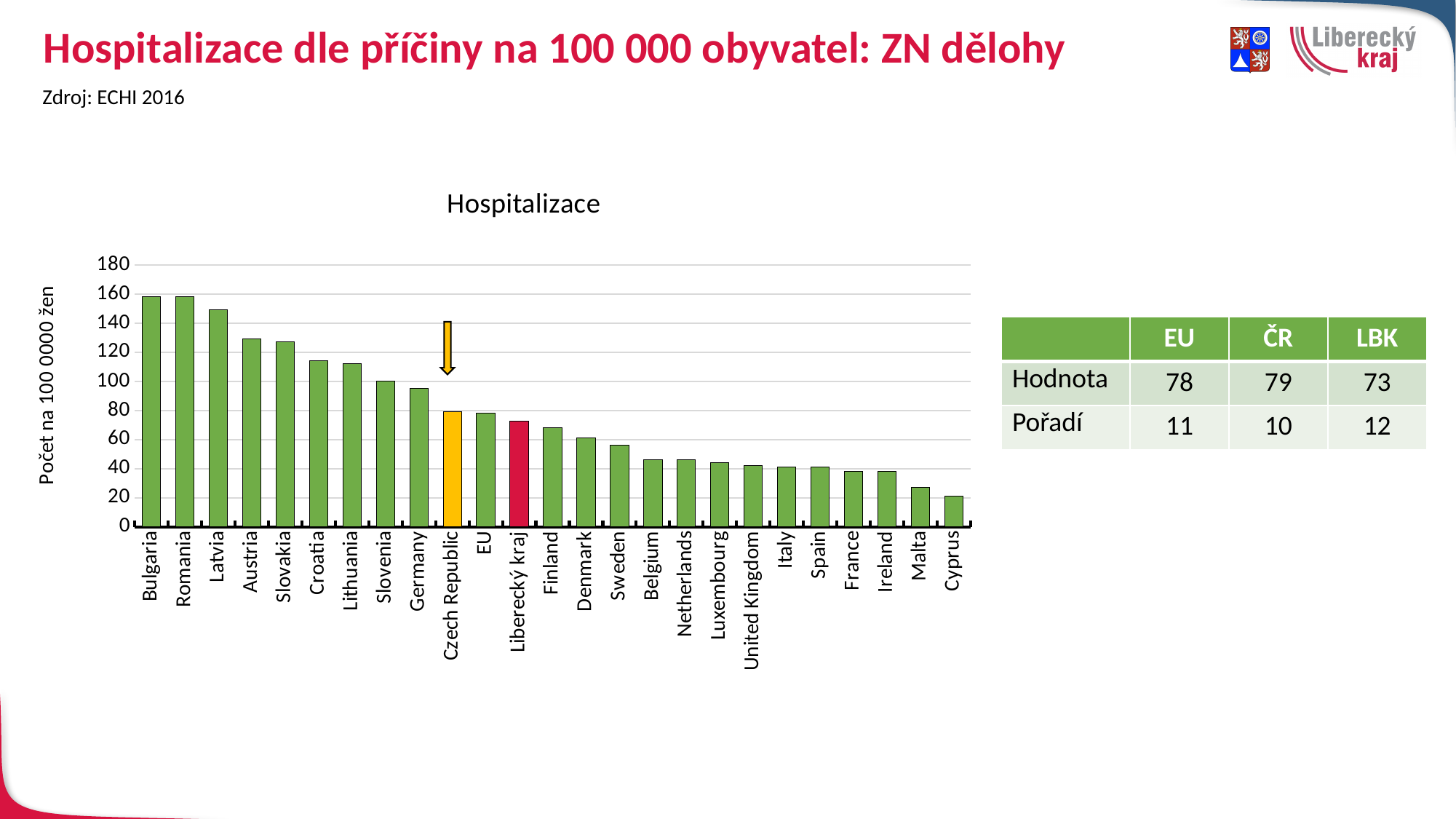
According to the table, what is the value for Liberecký kraj (LBK)? 73 How many categories (bars) are shown on the x axis of the chart? 25 Is the value for Bulgaria greater or less than 140? greater Which has a larger value, Latvia or Austria? Latvia What is the difference between the values for ČR and LBK shown in the table? 6 According to the table, what is the value for the Czech Republic (ČR)? 79 Which category has the lowest value in the chart? Cyprus What colour is the bar for the Czech Republic? yellow What kind of chart is shown on the slide? bar chart According to the table, what is the value for the EU? 78 Do the values generally rise or fall from left to right along the x axis? fall Is the value for Finland greater or less than 80? less